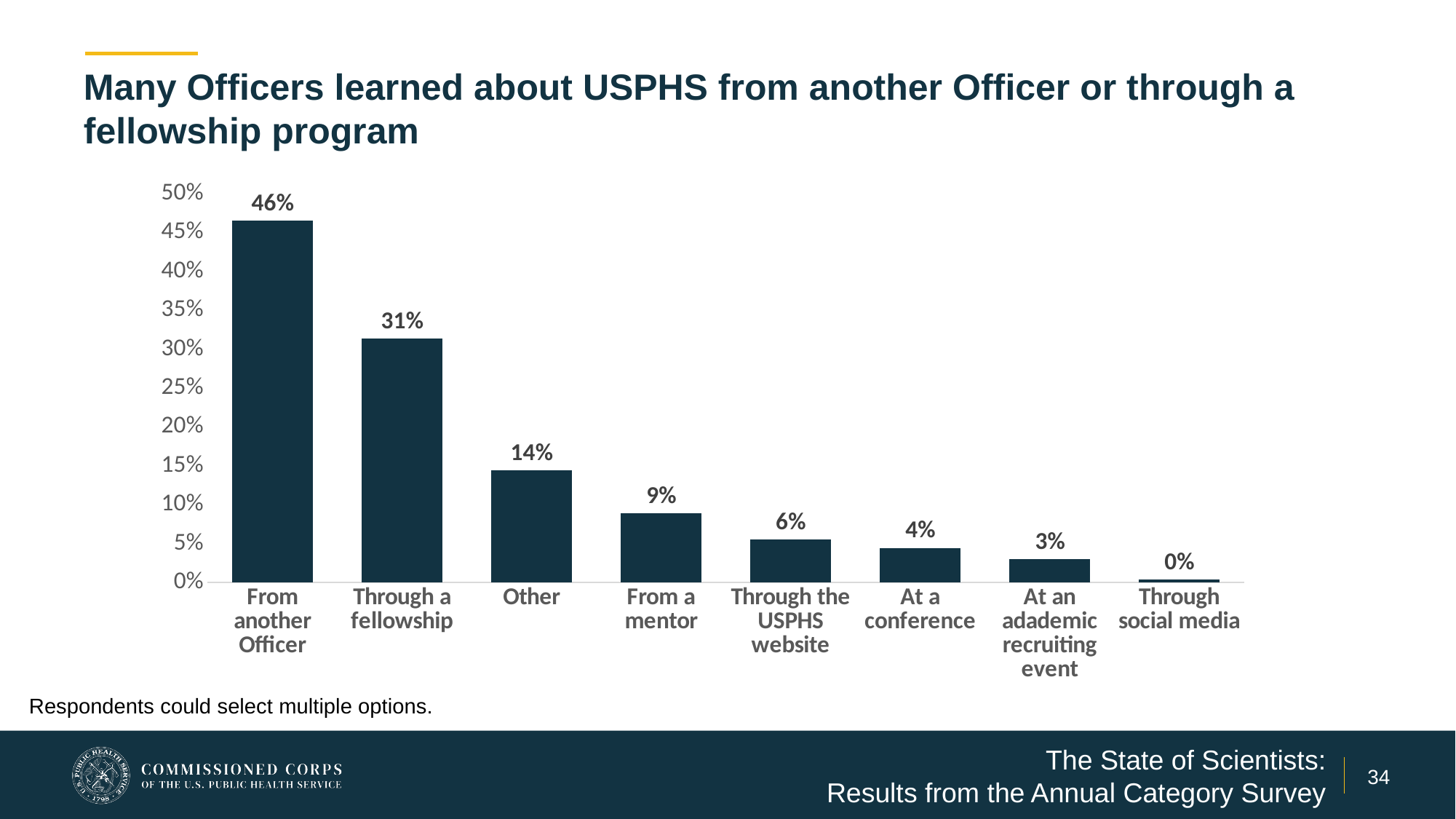
Which category has the lowest value? Through social media What percentage of Officers learned about USPHS from another Officer? 46% Which category has the highest value? From another Officer What is the difference between 'From another Officer' and 'Through a fellowship'? 15% What is the value for 'At an adademic recruiting event'? 3% Which is larger, 'From a mentor' or 'At a conference'? From a mentor What is the value for 'Through a fellowship'? 31% Is the value for 'Other' greater or less than 10%? greater What percentage of respondents learned about USPHS through the USPHS website? 6% Do the values rise or fall from left to right along the x axis? fall How many categories are shown on the x axis? 8 What kind of chart is shown on the slide? bar chart